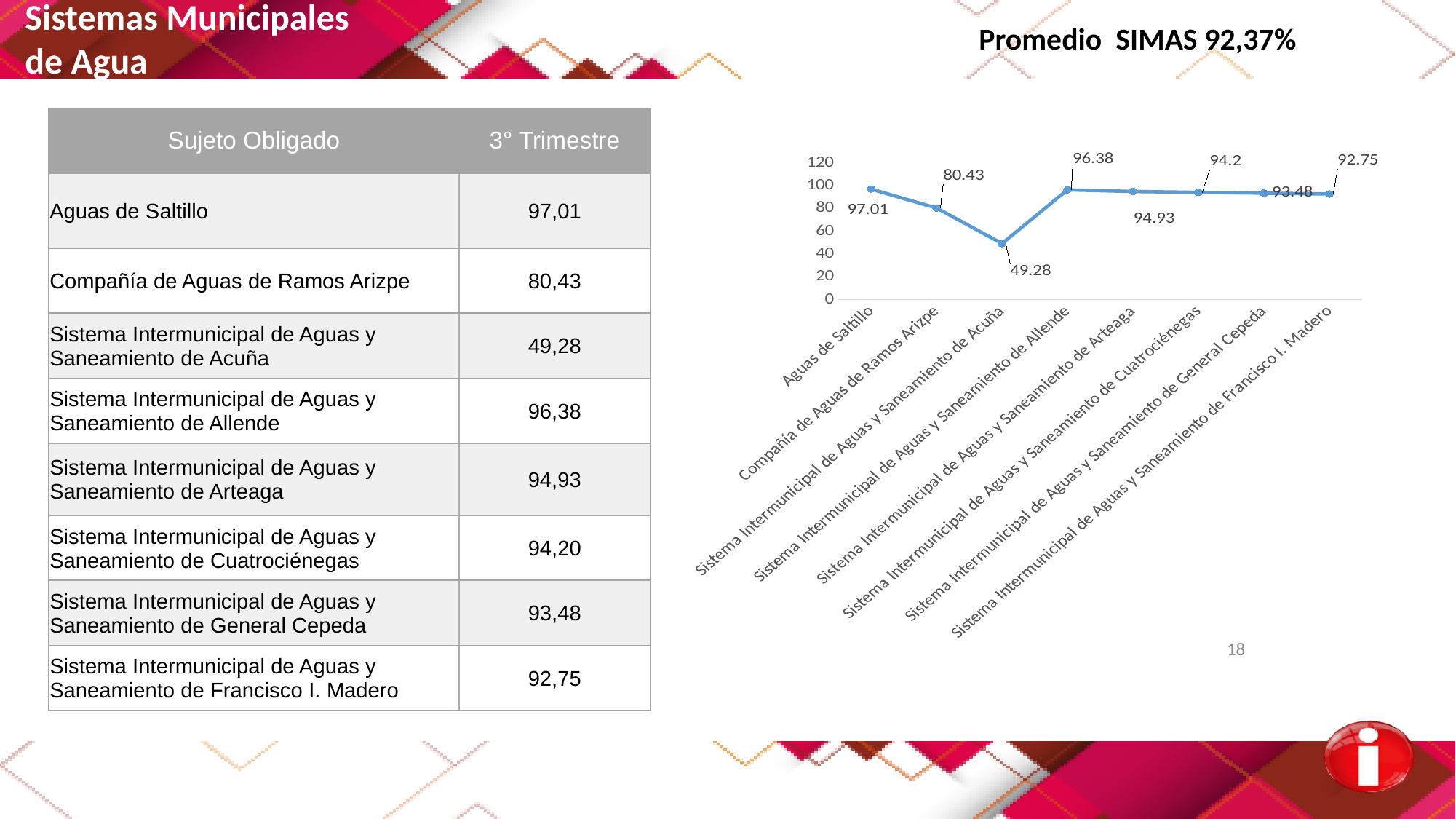
How many categories are plotted on the x axis of the chart? 8 Is the value for Compañía de Aguas de Ramos Arizpe in the chart greater or less than 100? less What kind of chart is shown on the slide? line chart Which category has the lowest value in the chart? Sistema Intermunicipal de Aguas y Saneamiento de Acuña Which has a larger value in the chart, Sistema Intermunicipal de Aguas y Saneamiento de Arteaga or Sistema Intermunicipal de Aguas y Saneamiento de General Cepeda? Sistema Intermunicipal de Aguas y Saneamiento de Arteaga What is the value plotted for Sistema Intermunicipal de Aguas y Saneamiento de Francisco I. Madero in the chart? 92.75 What is the maximum value shown on the chart's vertical axis? 120 What is the difference between the values for Aguas de Saltillo and Compañía de Aguas de Ramos Arizpe in the chart? 16.58 What is the value plotted for Sistema Intermunicipal de Aguas y Saneamiento de Allende in the chart? 96.38 What is the value plotted for Sistema Intermunicipal de Aguas y Saneamiento de Acuña in the chart? 49.28 What is the value plotted for Aguas de Saltillo in the chart? 97.01 Which category has the highest value in the chart? Aguas de Saltillo